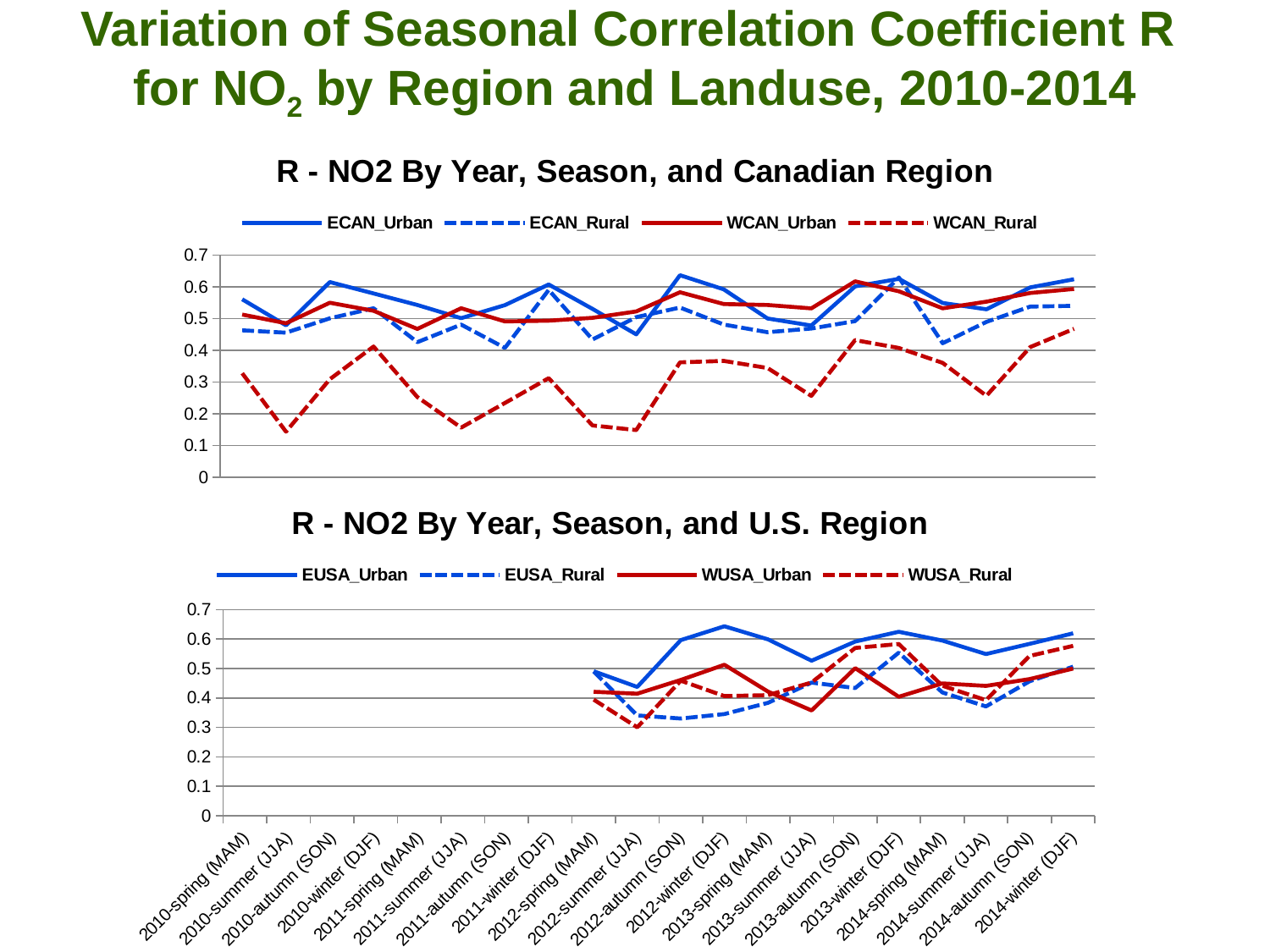
In the 'R - NO2 By Year, Season, and Canadian Region' chart, is the ECAN_Urban value for 2012-autumn (SON) greater or less than 0.6? greater In the 'R - NO2 By Year, Season, and U.S. Region' chart, is the EUSA_Rural value for 2012-autumn (SON) greater or less than 0.4? less In the 'R - NO2 By Year, Season, and U.S. Region' chart, at which x-axis category do the plotted lines begin? 2012-spring (MAM) In the 'R - NO2 By Year, Season, and Canadian Region' chart, which is larger at 2010-summer (JJA): ECAN_Urban or WCAN_Rural? ECAN_Urban How many series does the legend of the 'R - NO2 By Year, Season, and U.S. Region' chart list? 4 How many year-season categories are shown along the x axis of the 'R - NO2 By Year, Season, and U.S. Region' chart? 20 What kind of chart is the 'R - NO2 By Year, Season, and Canadian Region' chart? line chart In the 'R - NO2 By Year, Season, and U.S. Region' chart, is the EUSA_Urban value for 2012-winter (DJF) greater or less than 0.6? greater In the 'R - NO2 By Year, Season, and U.S. Region' chart, which is larger at 2012-winter (DJF): EUSA_Urban or WUSA_Urban? EUSA_Urban In the 'R - NO2 By Year, Season, and Canadian Region' chart, which series has the lowest value at 2011-summer (JJA)? WCAN_Rural How many series does the legend of the 'R - NO2 By Year, Season, and Canadian Region' chart list? 4